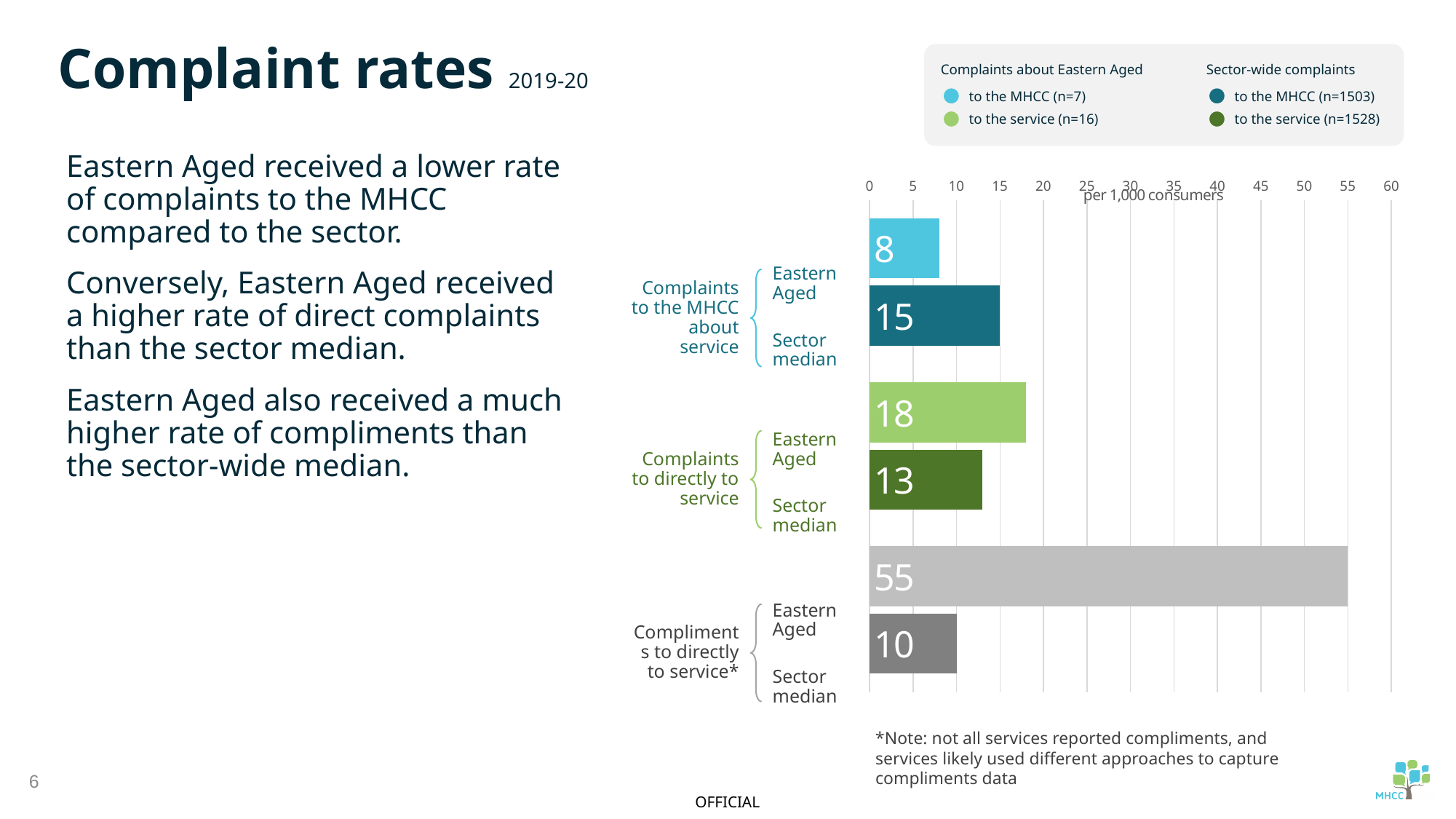
What is the rate of complaints to the MHCC about service for Eastern Aged? 8 What is the rate of complaints made directly to service for Eastern Aged? 18 For complaints made directly to service, which is larger: Eastern Aged or the sector median? Eastern Aged What is the sector median rate of compliments made directly to service? 10 What type of chart is shown on the slide? Bar chart What is the difference between the Eastern Aged and sector median rates of compliments made directly to service? 45 Which bar has the highest value on the chart? Compliments to directly to service, Eastern Aged (55) Which bar has the lowest value on the chart? Complaints to the MHCC about service, Eastern Aged (8) What unit does the chart's axis use, as labelled on the slide? per 1,000 consumers What is the sector median rate of complaints to the MHCC about service? 15 How many bars are plotted on the chart? 6 What is the difference between the sector median and Eastern Aged rates of complaints to the MHCC about service? 7